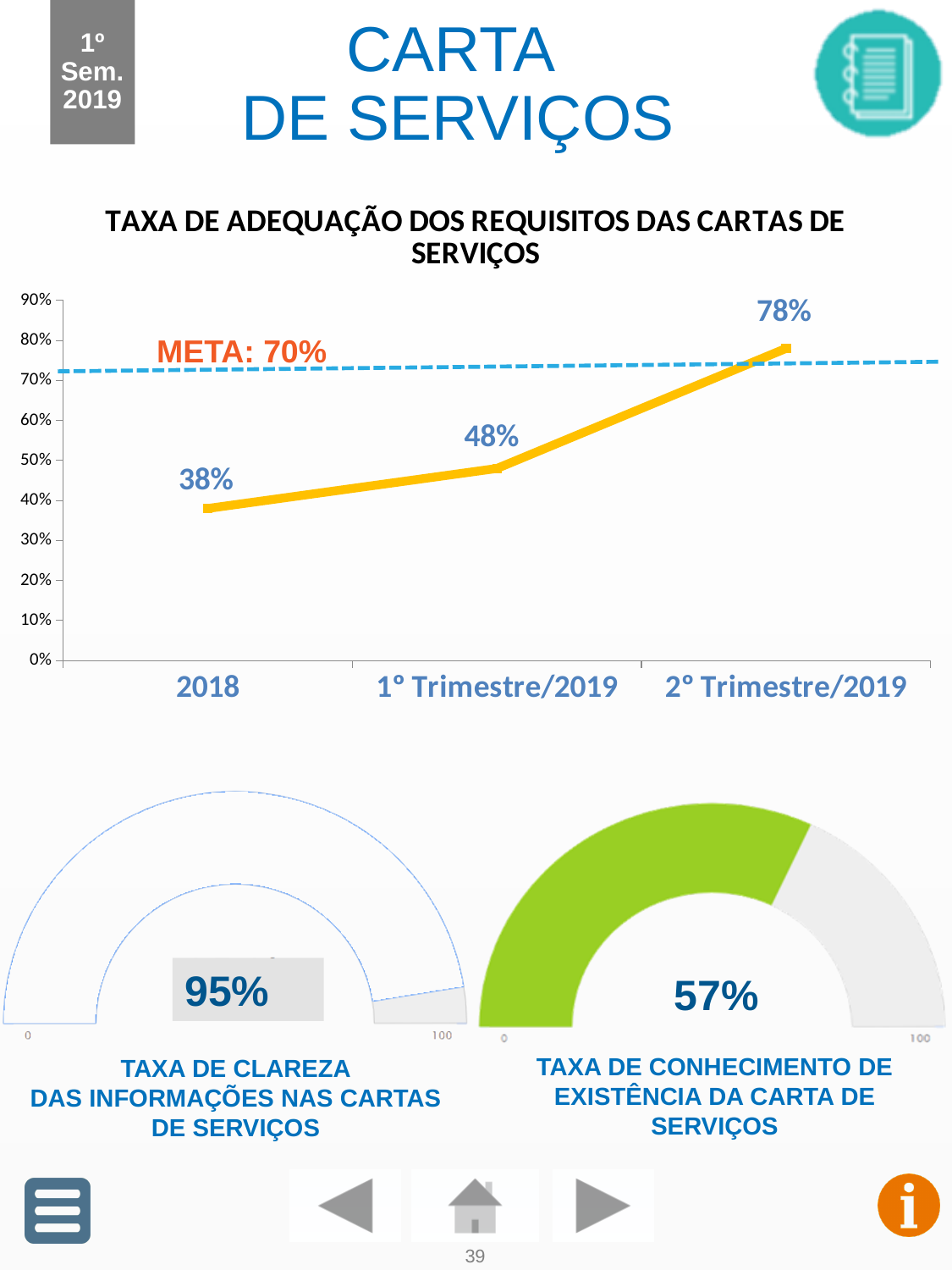
In the chart titled 'TAXA DE ADEQUAÇÃO DOS REQUISITOS DAS CARTAS DE SERVIÇOS', how many periods are plotted on the x axis? 3 In the chart titled 'TAXA DE ADEQUAÇÃO DOS REQUISITOS DAS CARTAS DE SERVIÇOS', which period has the highest value? 2° Trimestre/2019 In the chart titled 'TAXA DE ADEQUAÇÃO DOS REQUISITOS DAS CARTAS DE SERVIÇOS', what target (META) value is shown by the dashed line? 70% In the chart titled 'TAXA DE ADEQUAÇÃO DOS REQUISITOS DAS CARTAS DE SERVIÇOS', which period has the lowest value? 2018 In the chart titled 'TAXA DE ADEQUAÇÃO DOS REQUISITOS DAS CARTAS DE SERVIÇOS', do the values rise or fall from 2018 to 2° Trimestre/2019? rise In the chart titled 'TAXA DE ADEQUAÇÃO DOS REQUISITOS DAS CARTAS DE SERVIÇOS', what is the value for 1° Trimestre/2019? 48% In the chart titled 'TAXA DE ADEQUAÇÃO DOS REQUISITOS DAS CARTAS DE SERVIÇOS', what is the value for 2° Trimestre/2019? 78% In the chart titled 'TAXA DE ADEQUAÇÃO DOS REQUISITOS DAS CARTAS DE SERVIÇOS', what is the value for 2018? 38% What kind of chart is the chart titled 'TAXA DE ADEQUAÇÃO DOS REQUISITOS DAS CARTAS DE SERVIÇOS'? line chart In the chart titled 'TAXA DE ADEQUAÇÃO DOS REQUISITOS DAS CARTAS DE SERVIÇOS', what is the difference between the values for 2° Trimestre/2019 and 1° Trimestre/2019? 30% What value is shown on the gauge chart titled 'TAXA DE CONHECIMENTO DE EXISTÊNCIA DA CARTA DE SERVIÇOS' at the bottom right of the slide? 57% What value is shown on the gauge chart titled 'TAXA DE CLAREZA DAS INFORMAÇÕES NAS CARTAS DE SERVIÇOS' at the bottom left of the slide? 95%